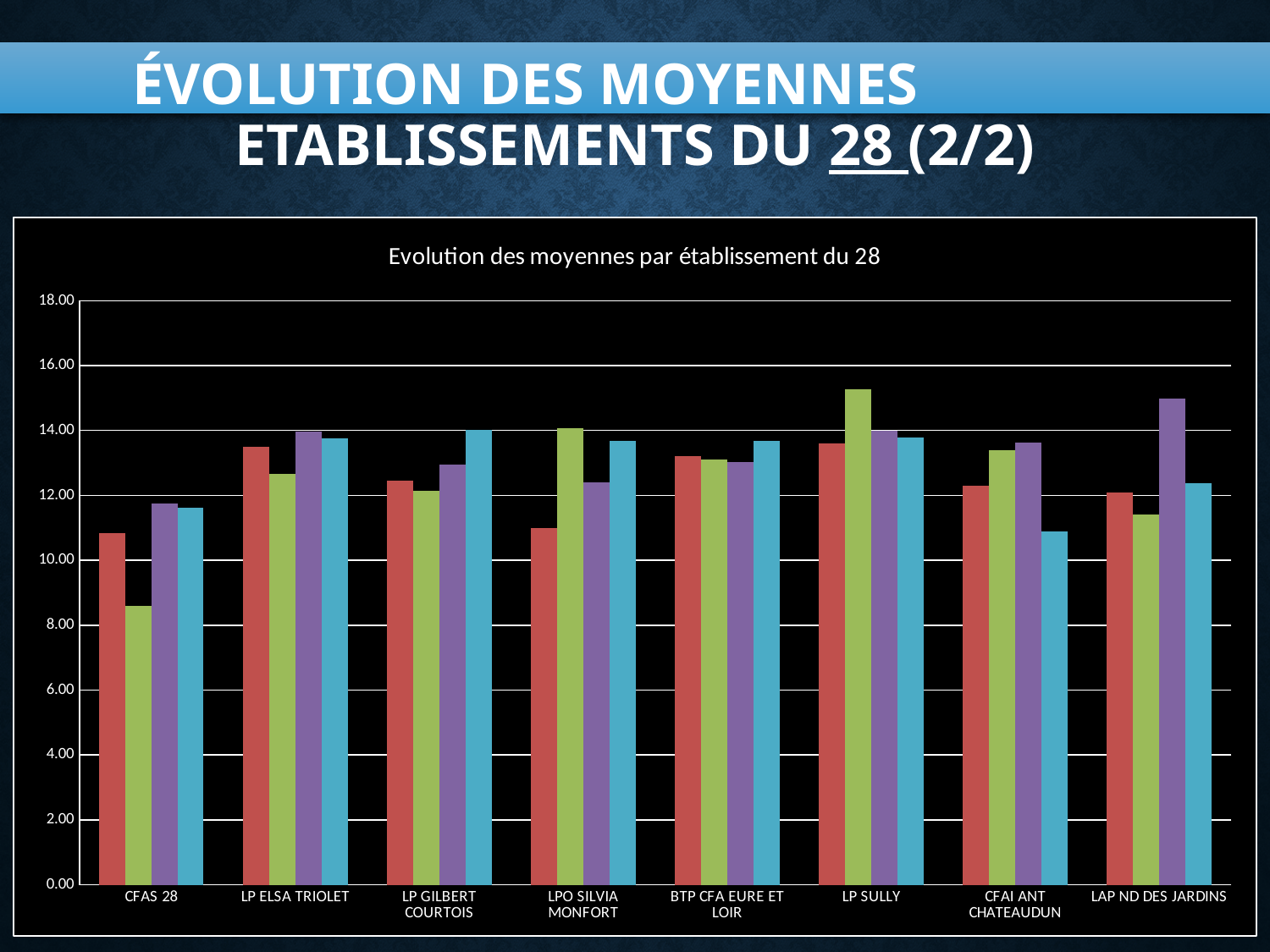
For LAP ND DES JARDINS, which is larger: the purple bar or the green bar? The purple bar Is the purple bar for LAP ND DES JARDINS greater or less than 14.00? greater What kind of chart is shown on the slide? Bar chart How many bars are plotted for each establishment in the chart? 4 Which establishment has the lowest bar in the whole chart? CFAS 28 Is the green bar for LP SULLY greater or less than 14.00? greater What is the highest value shown on the vertical axis of the chart? 18.00 What is the title of the chart? Evolution des moyennes par établissement du 28 For CFAS 28, which is larger: the red bar or the green bar? The red bar Is the green bar for CFAS 28 greater or less than 10.00? less How many establishments (categories) are shown on the x axis of the chart? 8